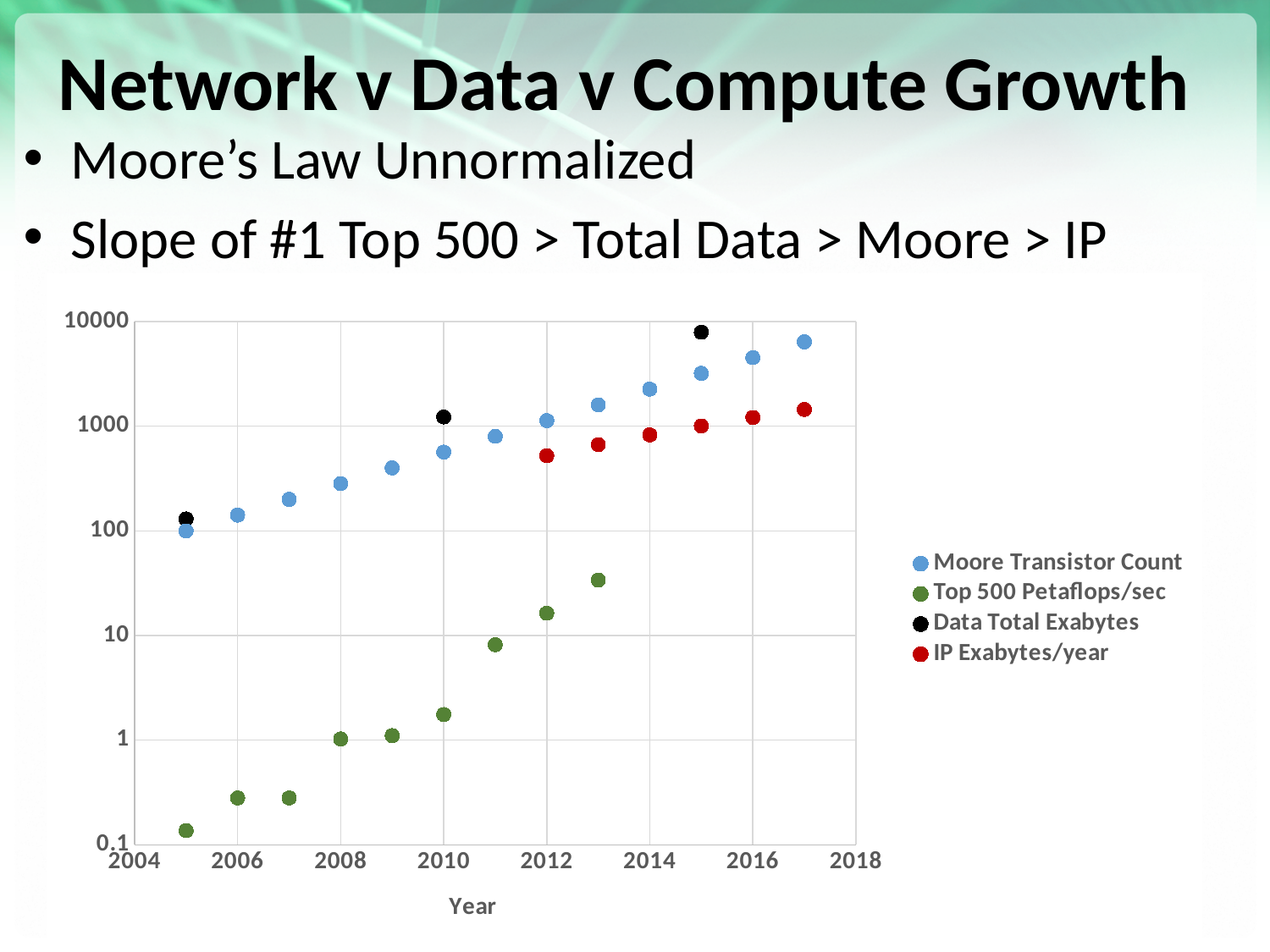
How many series does the chart legend list? 4 Is the Data Total Exabytes value for 2015 greater or less than 1000? greater In 2015, which is larger: Data Total Exabytes or Moore Transistor Count? Data Total Exabytes What kind of chart is shown on the slide? scatter chart Do the Moore Transistor Count values rise or fall as the year increases? rise Is the Top 500 Petaflops/sec value for 2005 greater or less than 1? less How many data points are plotted for the Data Total Exabytes series? 3 Which series is plotted with red markers? IP Exabytes/year Is the Top 500 Petaflops/sec value for 2012 greater or less than 10? greater How many data points are plotted for the IP Exabytes/year series? 6 What is the title of the x axis of the chart? Year